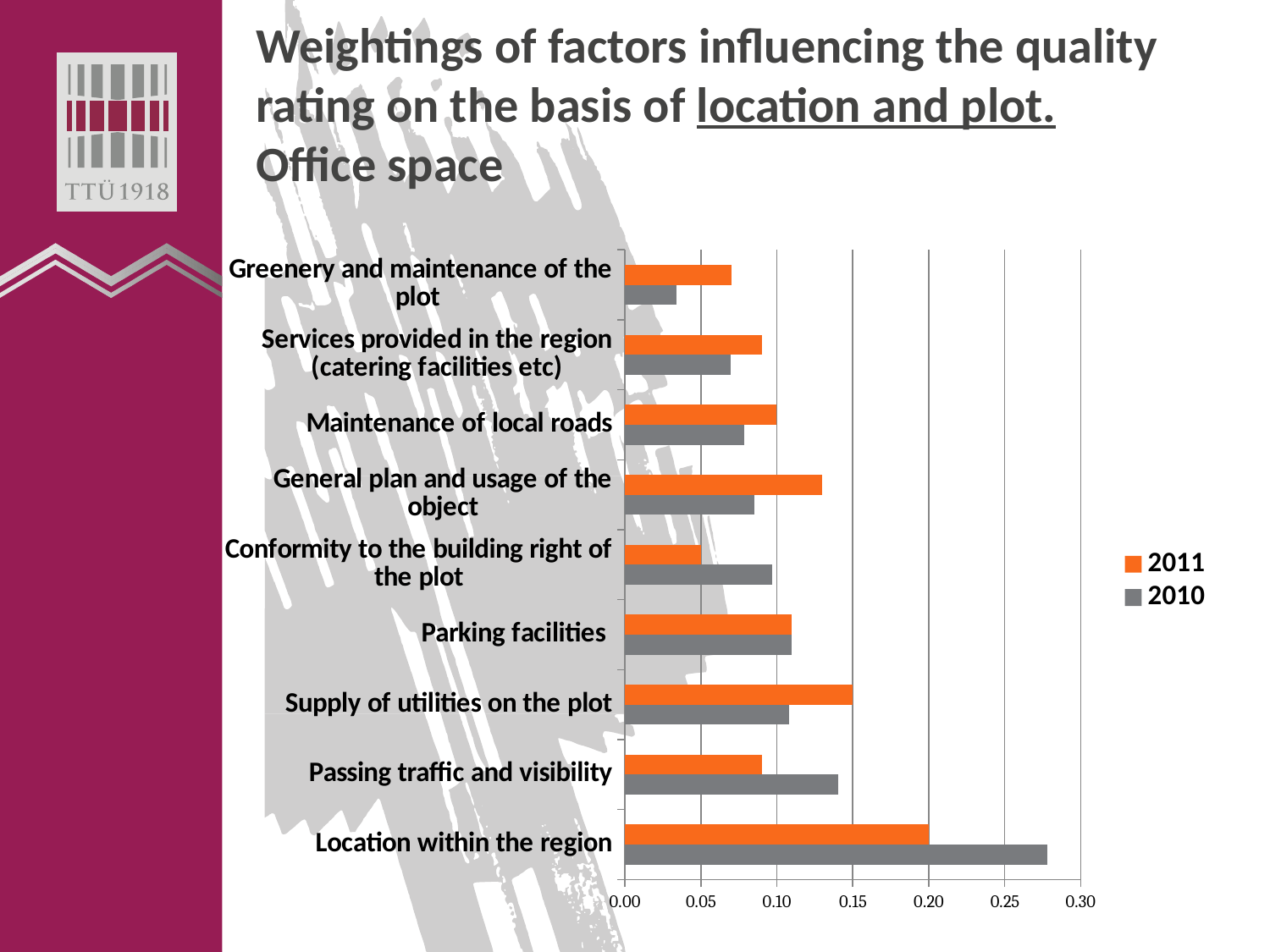
Which factor has the highest 2010 weighting? Location within the region Which factor has the lowest 2011 weighting? Conformity to the building right of the plot Is the 2010 value for Greenery and maintenance of the plot greater or less than 0.05? less Which factor has the lowest 2010 weighting? Greenery and maintenance of the plot What kind of chart is shown on the slide? bar chart For Location within the region, which year has the larger weighting, 2010 or 2011? 2010 Which colour represents the 2011 series in the legend? orange Is the 2010 value for Location within the region greater or less than 0.25? greater How many series does the legend list? 2 How many factor categories are plotted on the chart? 9 For Supply of utilities on the plot, which year has the larger weighting, 2010 or 2011? 2011 Which factor has the highest 2011 weighting? Location within the region